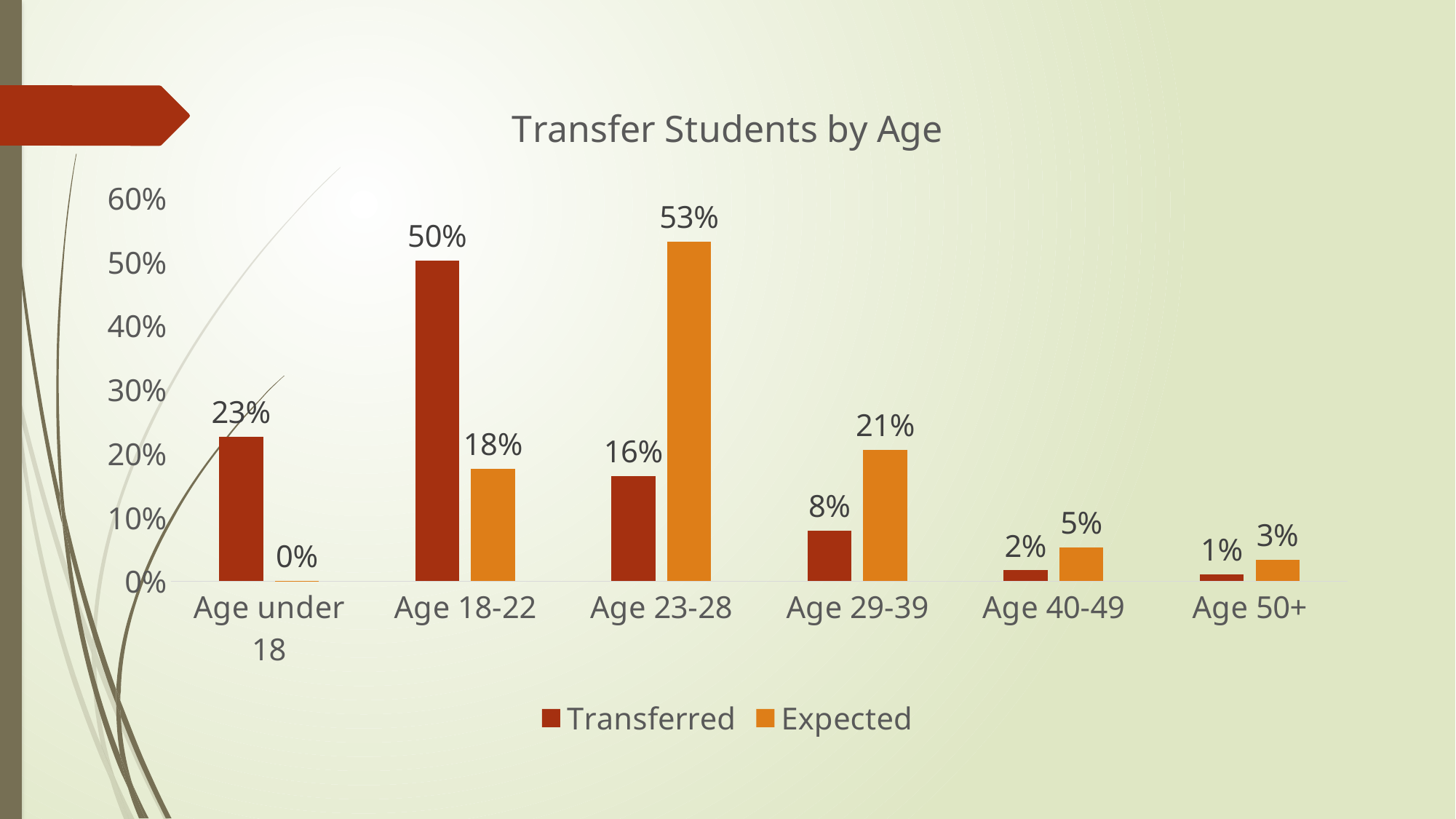
How many age groups are shown on the x axis? 6 Which age group has the lowest Expected value? Age under 18 What is the title of the chart? Transfer Students by Age What is the Transferred value for Age 50+? 1% What is the Expected value for Age under 18? 0% What is the Expected value for Age 23-28? 53% What is the Transferred value for Age 18-22? 50% What kind of chart is shown on the slide? Bar chart For Age 29-39, which is larger, the Transferred value or the Expected value? Expected Which age group has the highest Transferred value? Age 18-22 What is the difference between the Expected and Transferred values for Age 23-28? 37% How many series does the legend list? 2